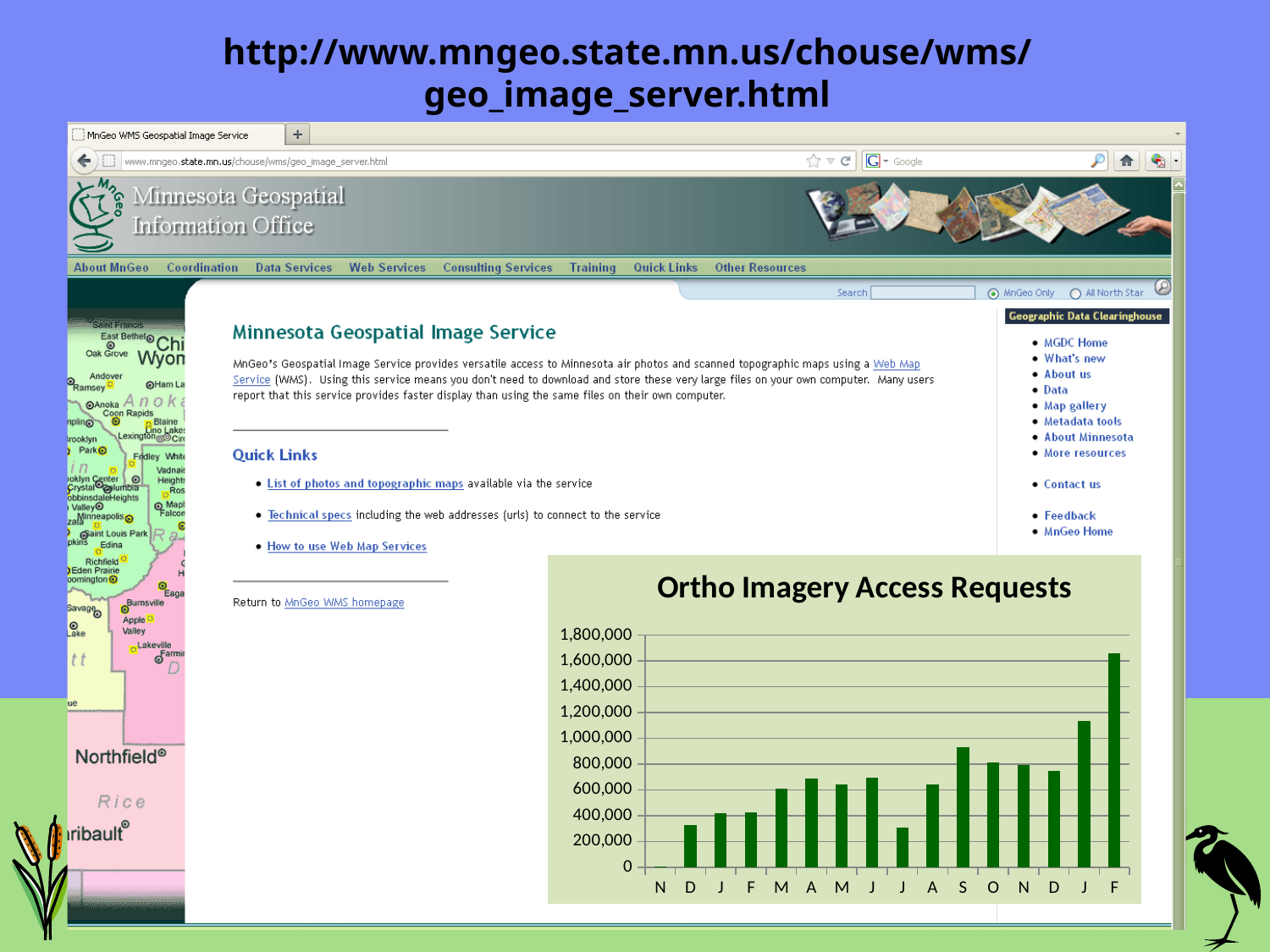
Which month has the highest value in the Ortho Imagery Access Requests chart? F (the last bar) In the Ortho Imagery Access Requests chart, is the value for the last F bar greater or less than 1,400,000? greater How many bars (months) are plotted in the Ortho Imagery Access Requests chart? 16 In the Ortho Imagery Access Requests chart, is the value for the first D bar greater or less than 400,000? less Which month has the lowest value in the Ortho Imagery Access Requests chart? N (the first bar) In the Ortho Imagery Access Requests chart, which is larger, the value for S or the value for O? S In the Ortho Imagery Access Requests chart, which is larger, the last F bar or the last J bar? F What kind of chart is the Ortho Imagery Access Requests chart? bar chart Overall, do the values in the Ortho Imagery Access Requests chart rise or fall from left to right? rise In the Ortho Imagery Access Requests chart, is the value for the last J bar (second from the right) greater or less than 1,000,000? greater What is the title of the chart on the slide? Ortho Imagery Access Requests